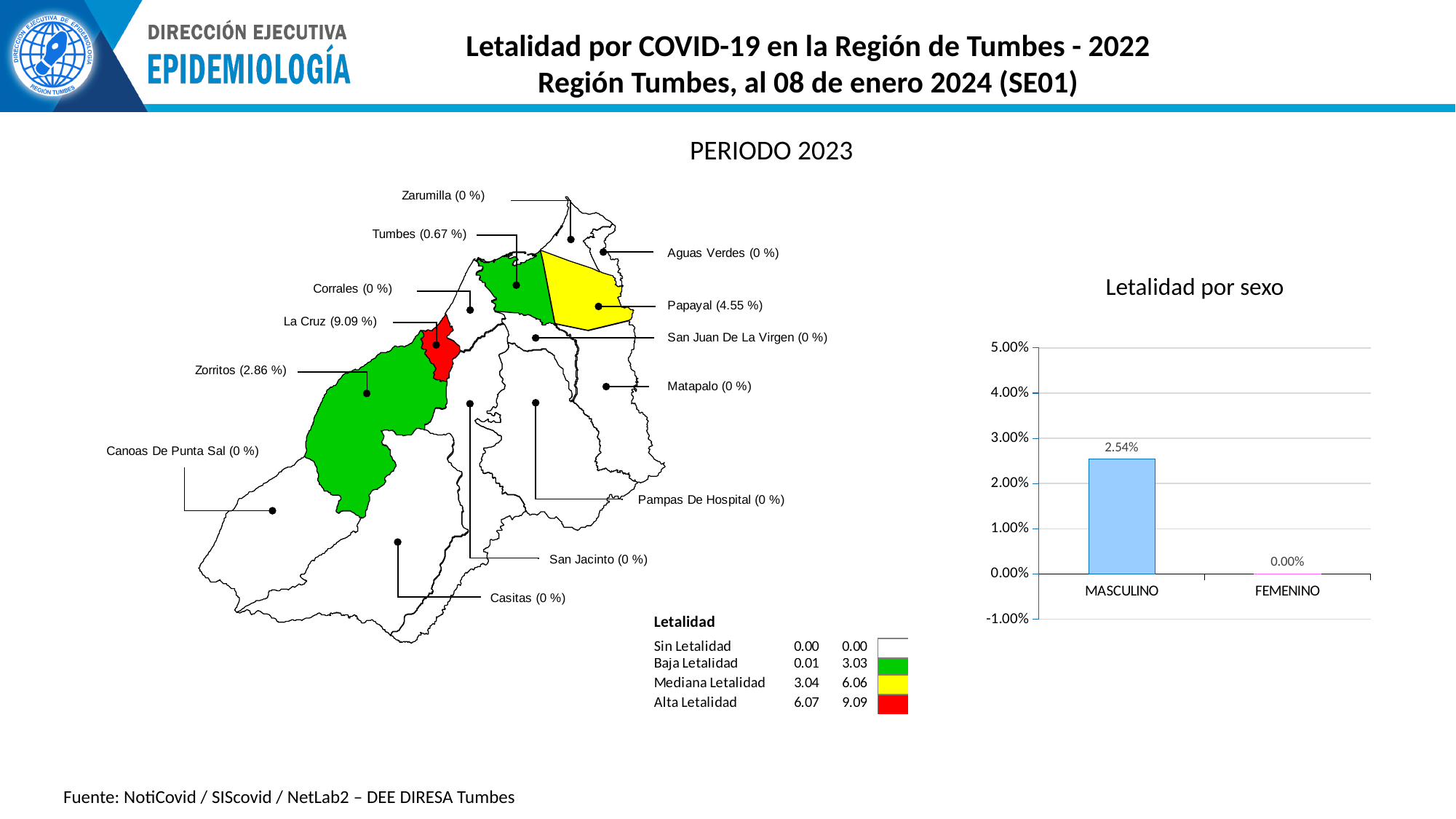
In the 'Letalidad por sexo' chart, which category has the highest value? MASCULINO In the 'Letalidad por sexo' chart, what is the value for MASCULINO? 2.54% In the 'Letalidad por sexo' chart, what is the difference between the MASCULINO and FEMENINO values? 2.54% On the map 'PERIODO 2023', what is the lethality value shown for Papayal? 4.55 % How many categories are shown in the 'Letalidad por sexo' chart? 2 In the 'Letalidad por sexo' chart, is the value for MASCULINO greater or less than 3.00%? less On the map 'PERIODO 2023', which district has the highest lethality value? La Cruz In the 'Letalidad por sexo' chart, what is the value for FEMENINO? 0.00% What is the title of the chart on the right side of the slide? Letalidad por sexo In the 'Letalidad por sexo' chart, which category has the lowest value? FEMENINO What kind of chart is 'Letalidad por sexo'? bar chart On the map 'PERIODO 2023', what is the lethality value shown for La Cruz? 9.09 %